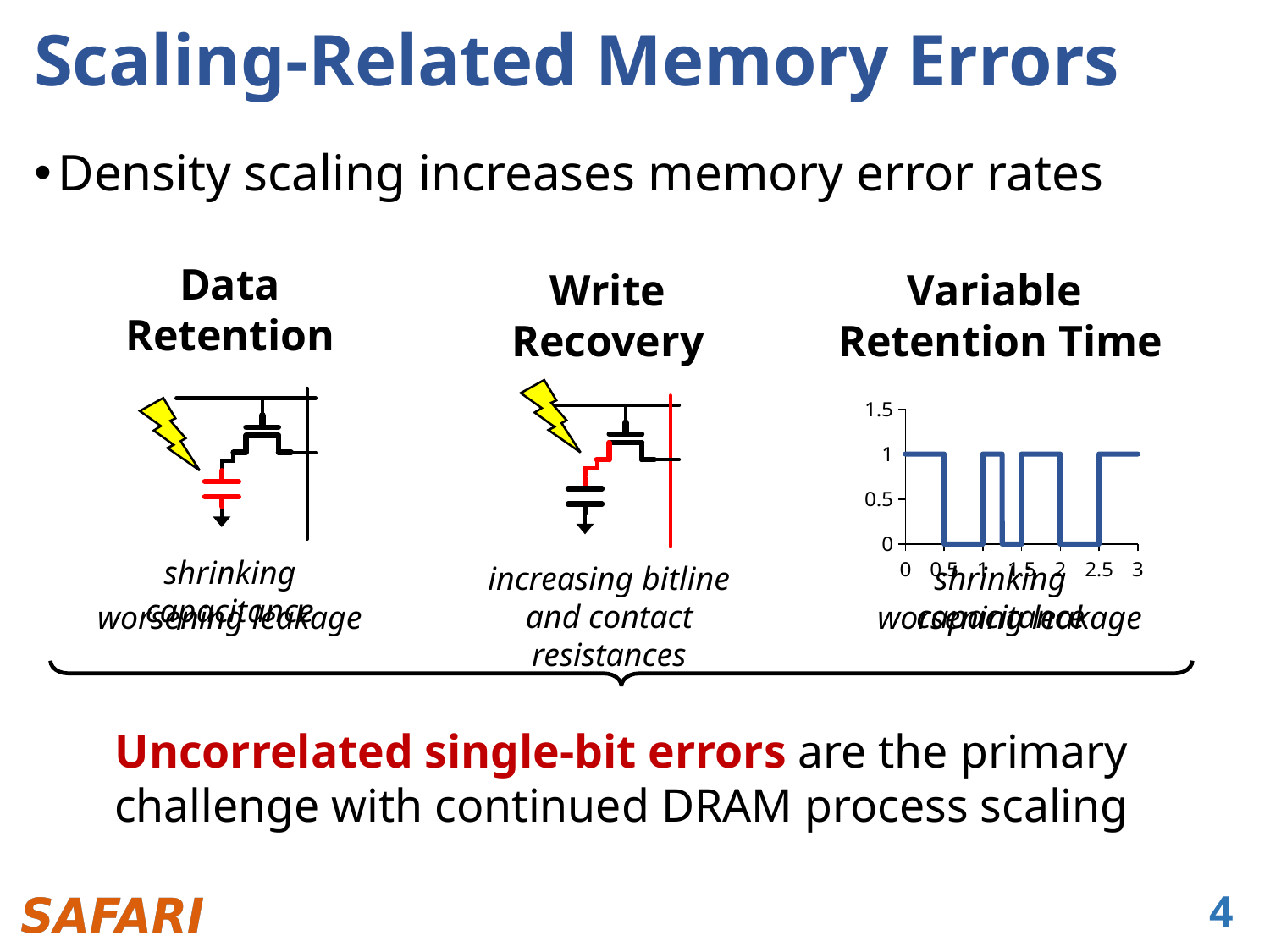
In the Variable Retention Time chart, is the value of the line at x = 0.75 greater or less than 0.5? less In the Variable Retention Time chart, is the value of the line at x = 3 greater or less than 0.5? greater In the Variable Retention Time chart, what is the value of the line at x = 3? 1 In the Variable Retention Time chart, what is the highest value the line reaches? 1 In the Variable Retention Time chart, is the value at x = 0 larger or smaller than the value at x = 0.75? larger In the Variable Retention Time chart, what is the lowest value the line reaches? 0 What kind of chart is shown under the "Variable Retention Time" heading? line chart In the Variable Retention Time chart, is the value of the line at x = 2.25 greater or less than 0.5? less In the Variable Retention Time chart, what is the highest tick label on the y axis? 1.5 In the Variable Retention Time chart, what is the highest tick label on the x axis? 3 In the Variable Retention Time chart, what is the value of the line at x = 0? 1